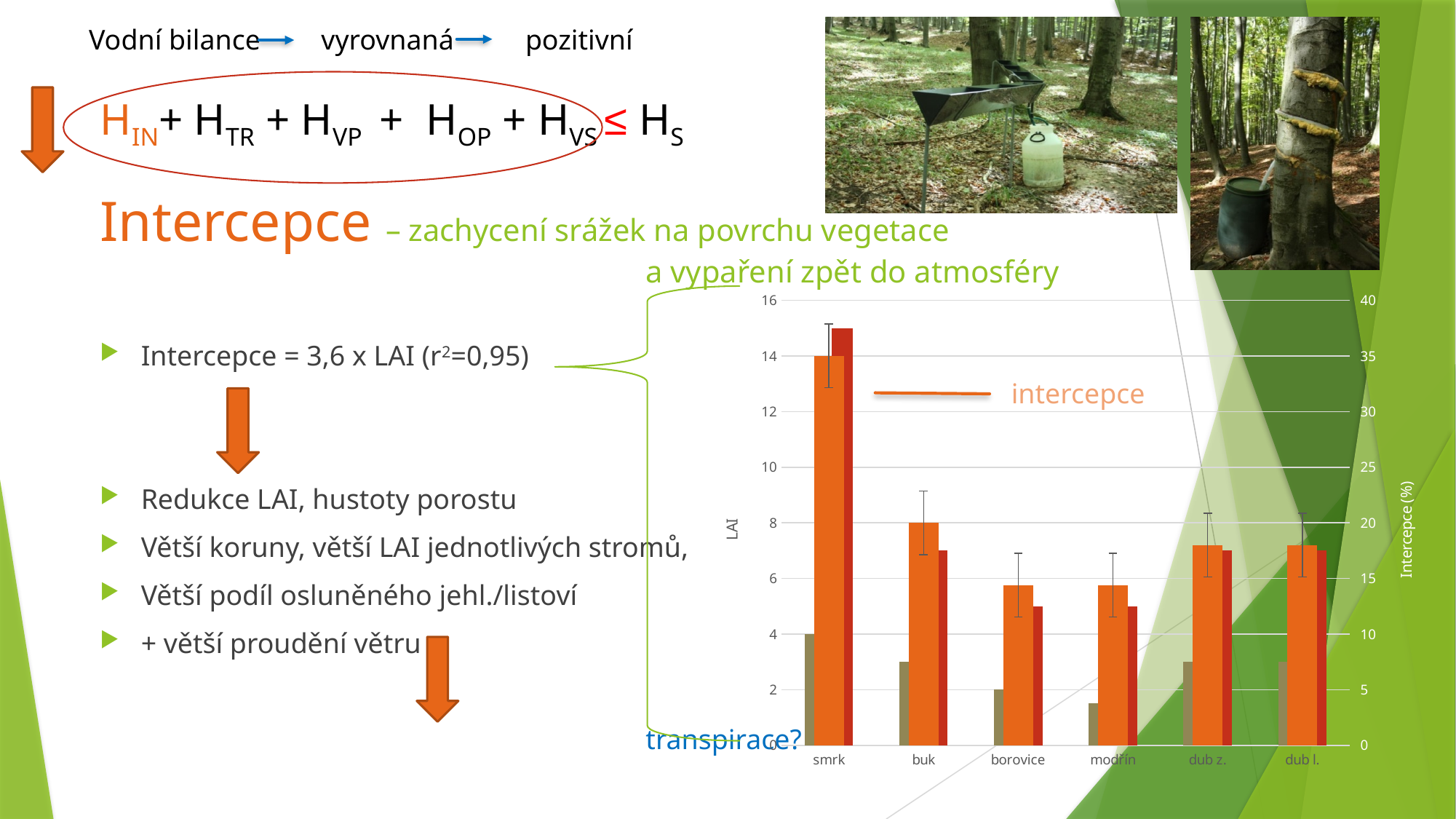
What is the label of the right vertical axis of the chart? Intercepce (%) What is the label of the left vertical axis of the chart? LAI Is the orange (intercepce) bar for borovice greater or less than 4 on the LAI axis? greater Is the orange (intercepce) bar for smrk greater or less than 12 on the LAI axis? greater Is the orange (intercepce) bar for modřín greater or less than 8 on the LAI axis? less How many tree species categories are shown on the x axis of the chart? 6 What kind of chart is shown on the slide? bar chart Which category has the tallest orange (intercepce) bar in the chart? smrk What is the highest tick value shown on the right vertical axis of the chart? 40 Which has the taller orange (intercepce) bar, smrk or buk? smrk Which has the taller orange (intercepce) bar, buk or borovice? buk